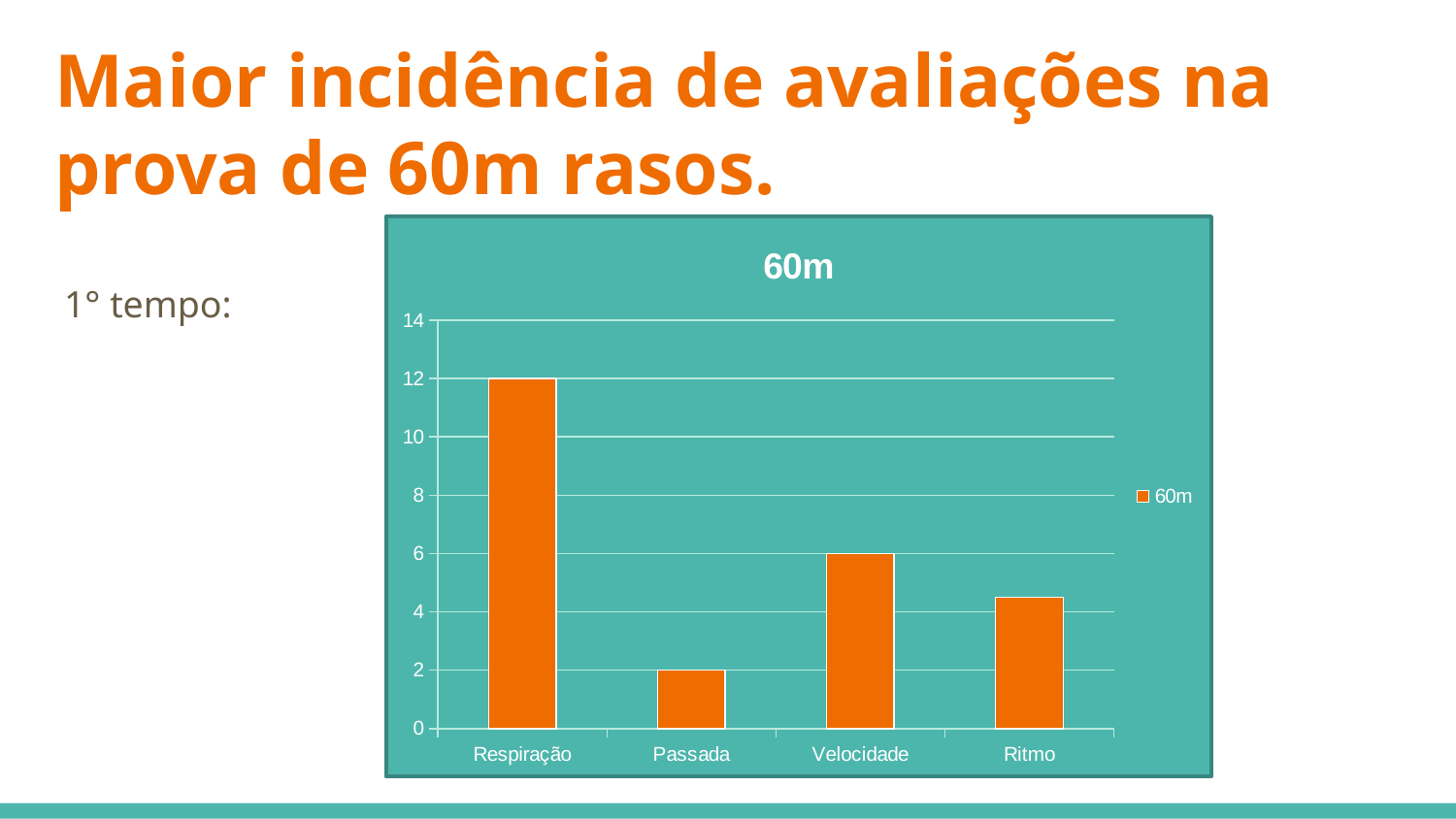
Is the value for Ritmo greater or less than 6? less How many series does the legend list? 1 How many categories are shown on the x axis of the chart? 4 What is the value for Respiração? 12 Which category has the lowest value? Passada What is the title of the chart? 60m Which is larger, the value for Velocidade or the value for Ritmo? Velocidade Which category has the highest value? Respiração What is the value for Passada? 2 What is the difference between the values for Respiração and Passada? 10 What type of chart is shown on the slide? bar chart What is the value for Velocidade? 6